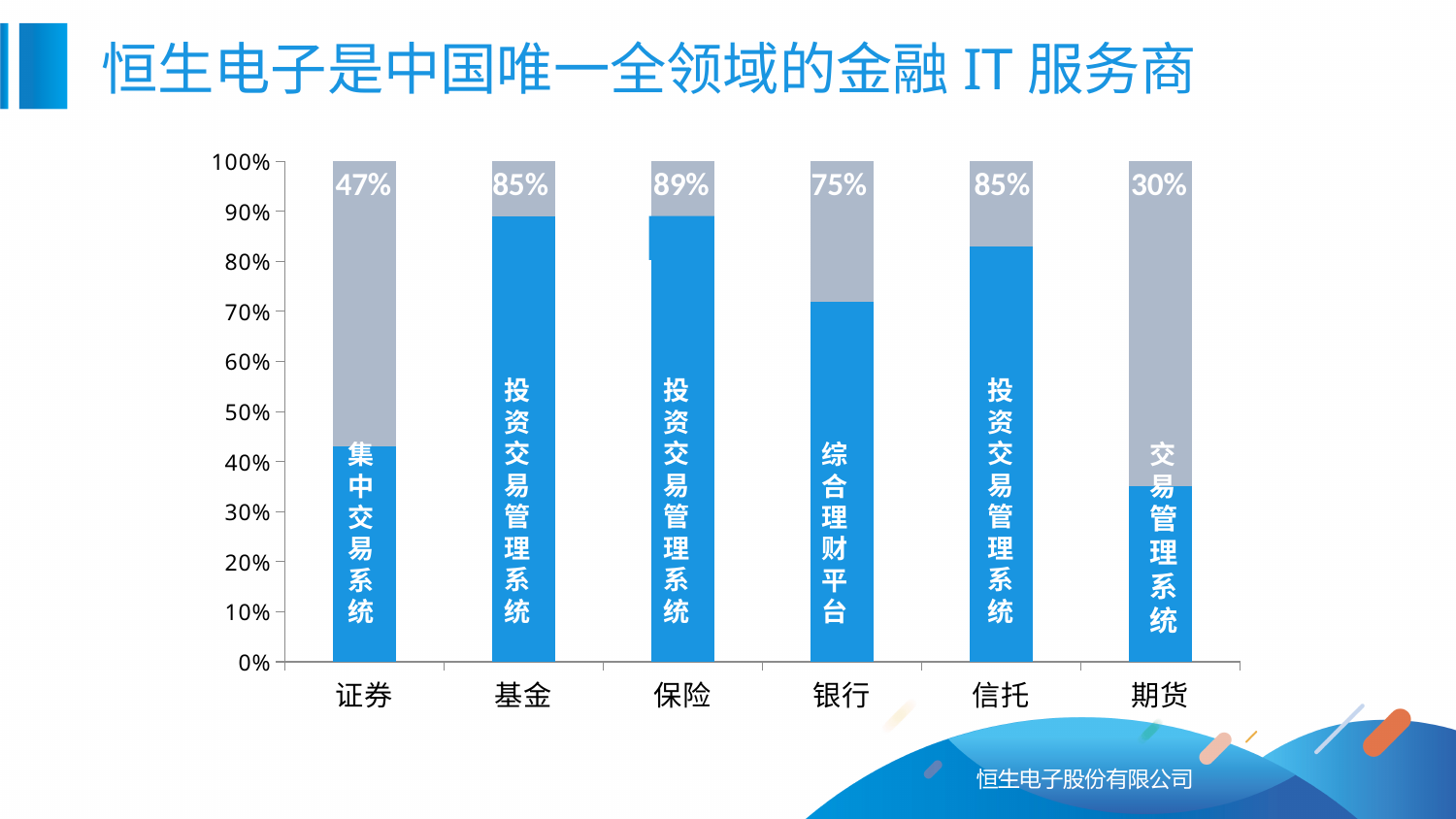
What is the difference between the percentage labels for 保险 and 期货? 59% What percentage label is shown on the bar for 银行? 75% What percentage label is shown on the bar for 证券? 47% How many categories are shown on the x axis? 6 What text is written inside the bar for 银行? 综合理财平台 Is the blue portion of the bar for 证券 greater or less than 50%? less What kind of chart is shown on the slide? Stacked bar chart Which has a larger percentage label, 基金 or 银行? 基金 What percentage label is shown on the bar for 期货? 30% What percentage label is shown on the bar for 保险? 89% Which category has the highest percentage label? 保险 Which category has the lowest percentage label? 期货